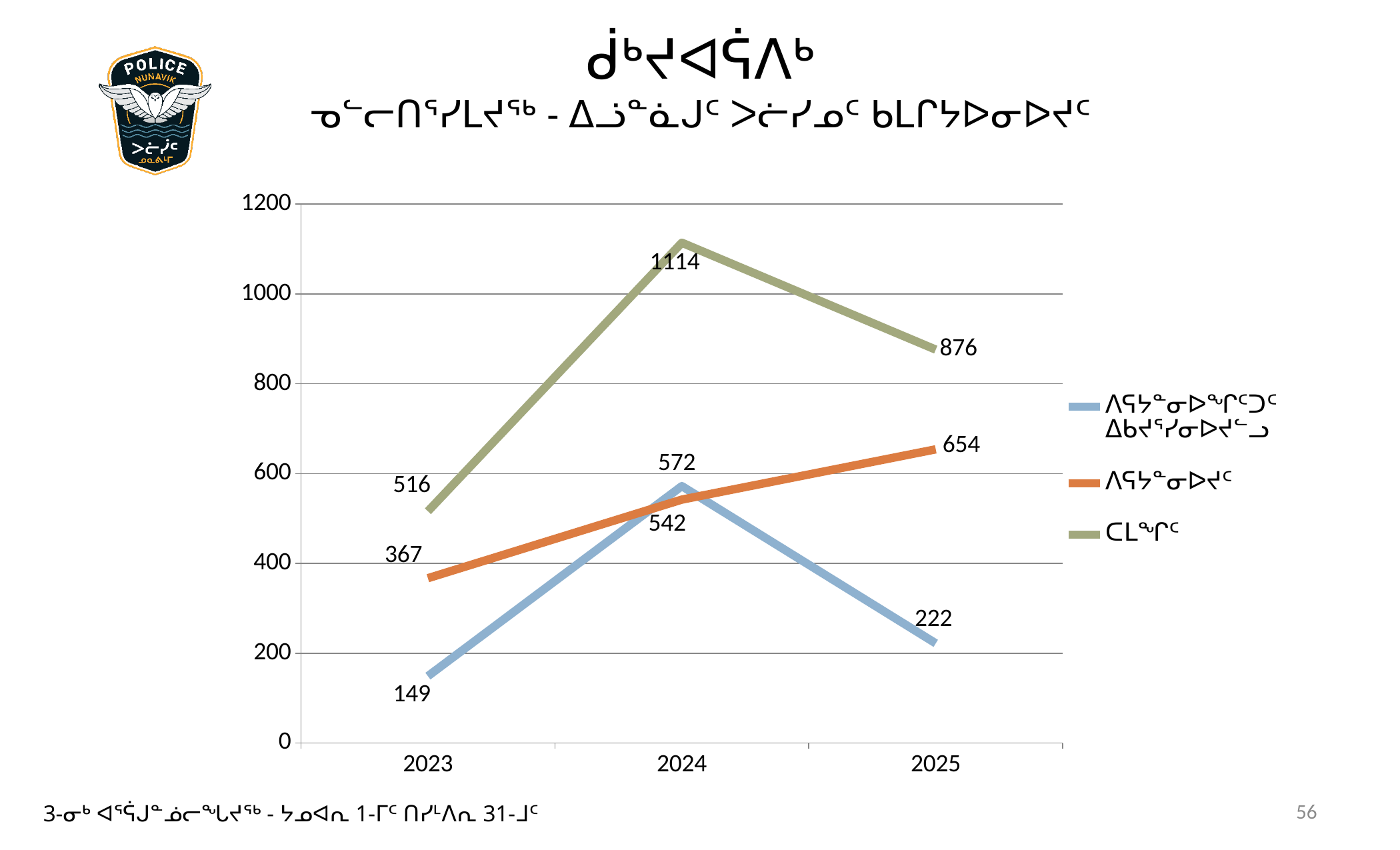
Which is larger in 2024, the blue line's value or the orange line's value? the blue line (572) How many series does the legend list? 3 What type of chart is shown on the slide? line chart Does the orange line rise or fall from 2023 to 2025? rise What is the difference between the green line's value in 2024 and its value in 2025? 238 In which year is the blue line at its lowest value? 2023 What is the value of the blue line in 2023? 149 What is the value of the green line in 2024? 1114 In which year does the green line reach its highest value? 2024 How many years are shown on the x axis? 3 What is the difference between the orange line's value in 2025 and its value in 2023? 287 What is the value of the orange line in 2025? 654